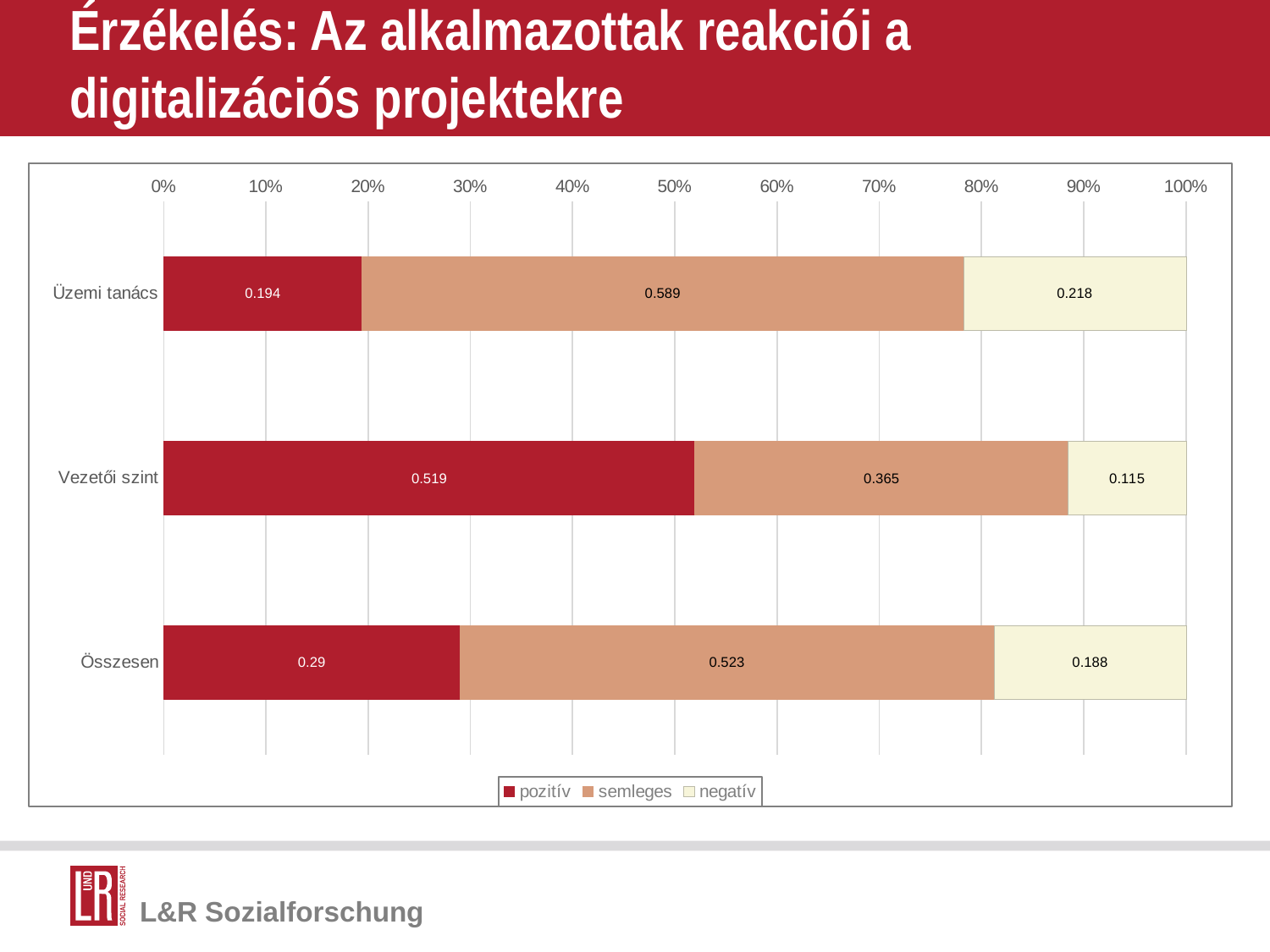
How many categories are shown on the vertical axis? 3 What kind of chart is shown on the slide? Stacked bar chart Which category has the highest pozitív value? Vezetői szint How many series does the legend list? 3 What is the semleges value for Üzemi tanács? 0.589 What is the difference between the pozitív values for Vezetői szint and Üzemi tanács? 0.325 Which is larger, the semleges value for Üzemi tanács or for Összesen? Üzemi tanács What is the negatív value for Összesen? 0.188 What is the pozitív value for Vezetői szint? 0.519 Which series is shown in dark red in the legend? pozitív Which category has the lowest negatív value? Vezetői szint What is the negatív value for Vezetői szint? 0.115